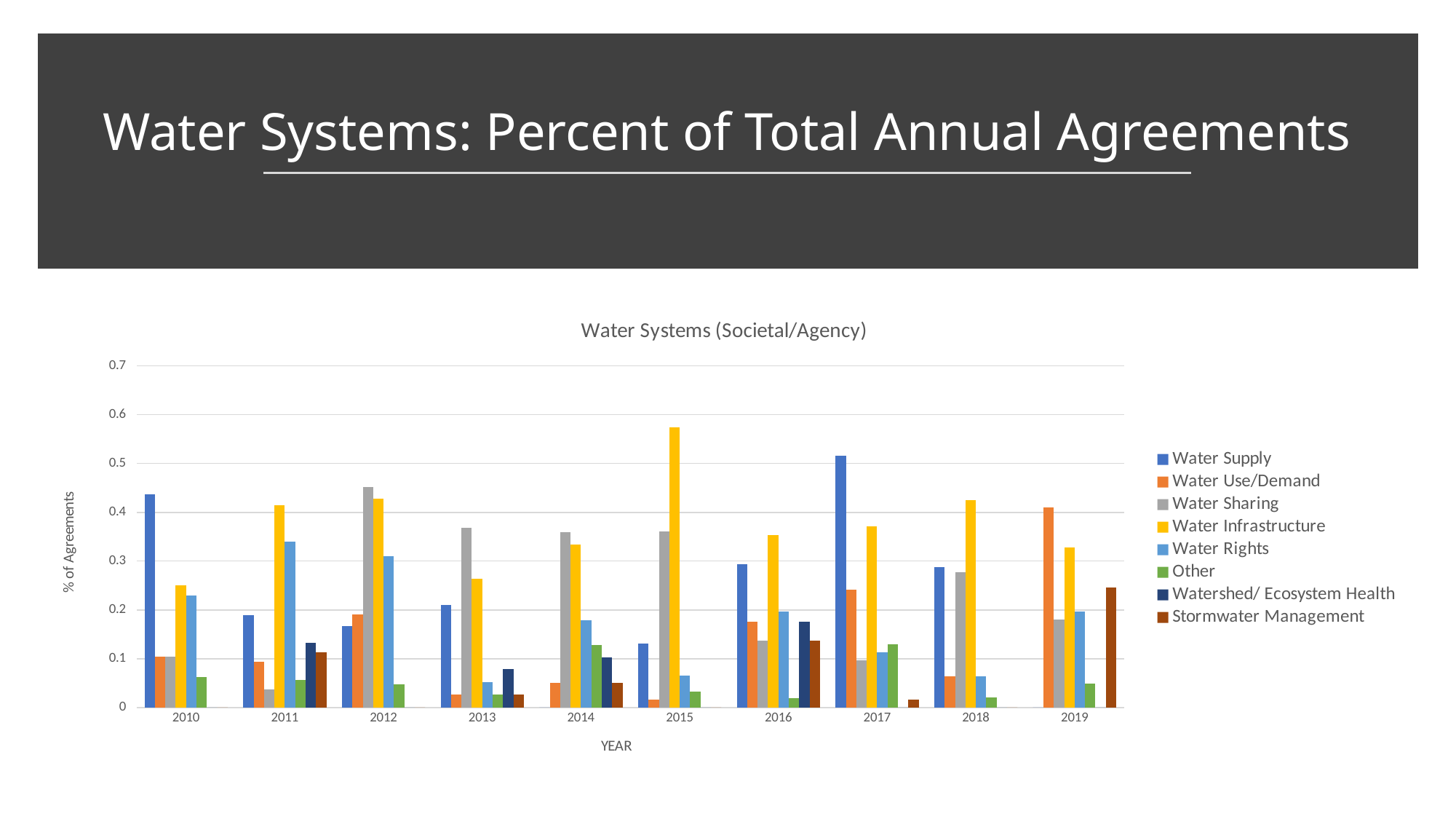
Which series has the highest bar in 2019? Water Use/Demand How many years are shown along the x axis? 10 What is the label on the y axis? % of Agreements What kind of chart is shown on the slide? bar chart How many series does the legend list? 8 Which series has the highest bar in 2010? Water Supply In which year is the Water Infrastructure bar the highest? 2015 Is the value for Stormwater Management in 2019 greater or less than 0.3? less Is the value for Water Infrastructure in 2015 greater or less than 0.5? greater Which is larger: Water Supply in 2010 or Water Supply in 2011? Water Supply in 2010 Is the value for Water Supply in 2010 greater or less than 0.4? greater